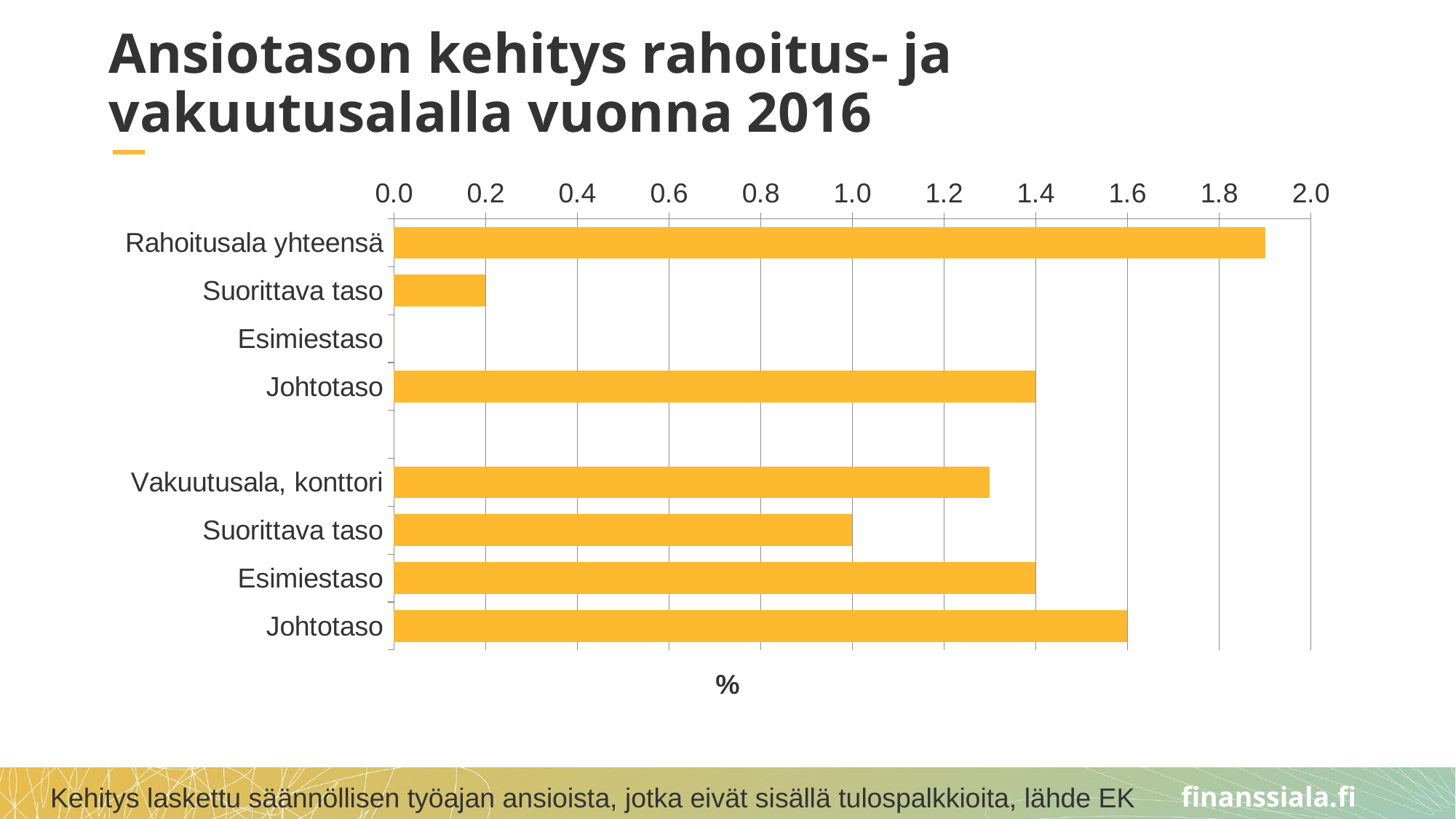
Is the value for Vakuutusala, konttori greater or less than 1.4? less Which is larger: Johtotaso in the Vakuutusala group or Johtotaso in the Rahoitusala group? Johtotaso in the Vakuutusala group Is the value for Rahoitusala yhteensä greater or less than 1.8? greater What is the difference between Johtotaso and Suorittava taso in the Vakuutusala group? 0.6 How many labelled categories are shown on the vertical axis of the chart? 8 What type of chart is shown on the slide? Bar chart Which category has the highest value in the chart? Rahoitusala yhteensä What is the value for Johtotaso in the Rahoitusala group? 1.4 What is the value for Suorittava taso in the Rahoitusala group? 0.2 What is the value for Suorittava taso in the Vakuutusala group? 1.0 Which category has the lowest value (no visible bar) in the chart? Esimiestaso (Rahoitusala) What is the value for Johtotaso in the Vakuutusala group? 1.6